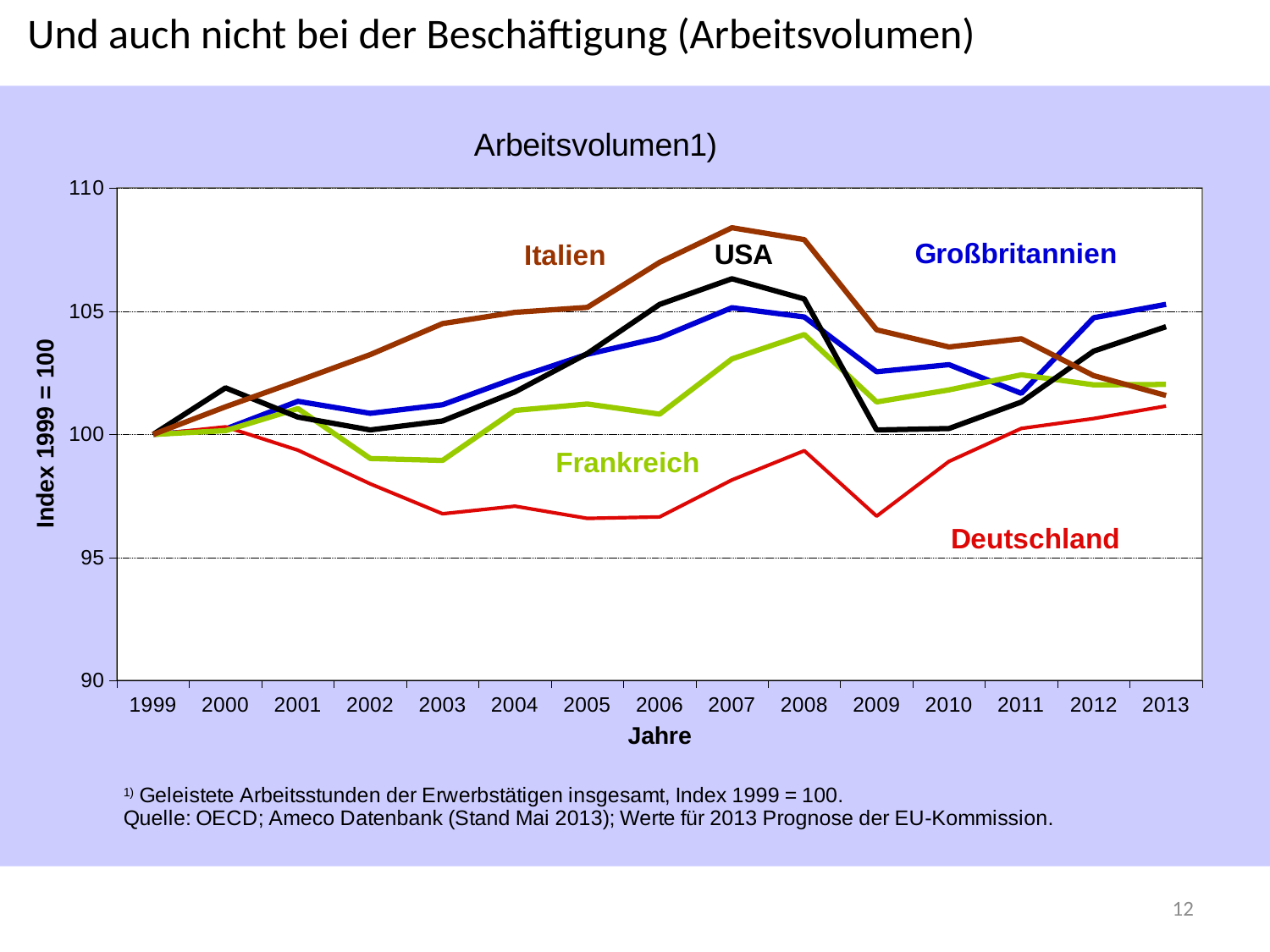
What kind of chart is shown on the slide? line chart What is the label of the y axis of the chart? Index 1999 = 100 Which country has the lowest value in 2003? Deutschland Is the value for Deutschland in 2009 greater or less than 95? greater Is the value for Deutschland in 2003 greater or less than 100? less Is the value for Italien in 2007 greater or less than 105? greater How many countries (series) are plotted in the chart? 5 What is the index value for all countries in 1999? 100 Does the value for Deutschland rise or fall from 1999 to 2003? fall Which is larger in 2005, the value for Italien or the value for Frankreich? Italien How many years are shown on the x axis of the chart? 15 Which country has the highest value in 2007? Italien